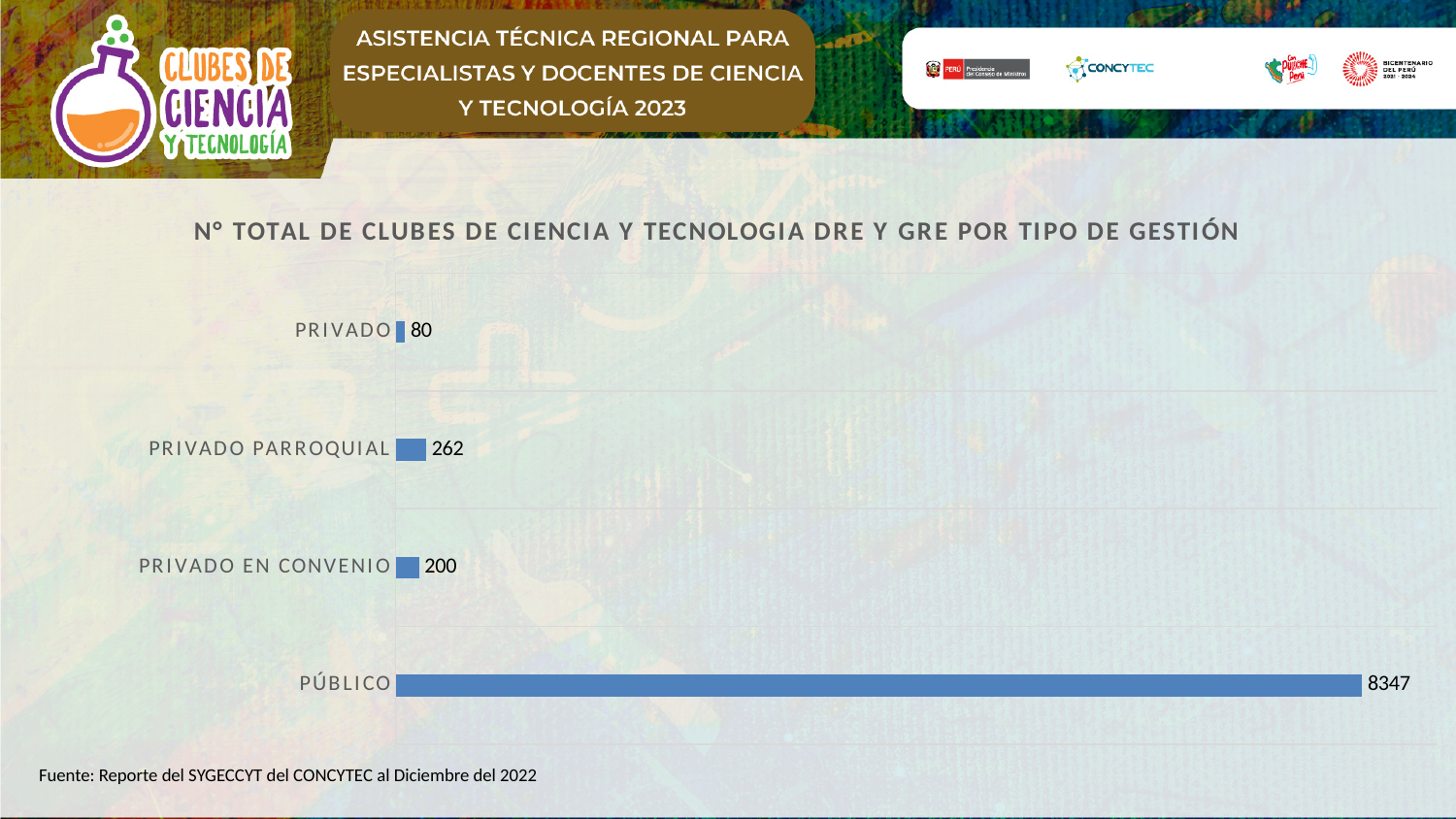
What kind of chart is shown on the slide? bar chart What is the value for PRIVADO EN CONVENIO? 200 Which category has the highest value? PÚBLICO What is the value for PRIVADO PARROQUIAL? 262 Which category has the lowest value? PRIVADO Which is larger, the value for PRIVADO PARROQUIAL or the value for PRIVADO EN CONVENIO? PRIVADO PARROQUIAL How many categories are shown in the chart? 4 What is the value for PRIVADO? 80 What is the value for PÚBLICO? 8347 What is the difference between the values for PÚBLICO and PRIVADO? 8267 What is the title of the chart? N° TOTAL DE CLUBES DE CIENCIA Y TECNOLOGIA DRE Y GRE POR TIPO DE GESTIÓN What is the difference between the values for PRIVADO PARROQUIAL and PRIVADO EN CONVENIO? 62